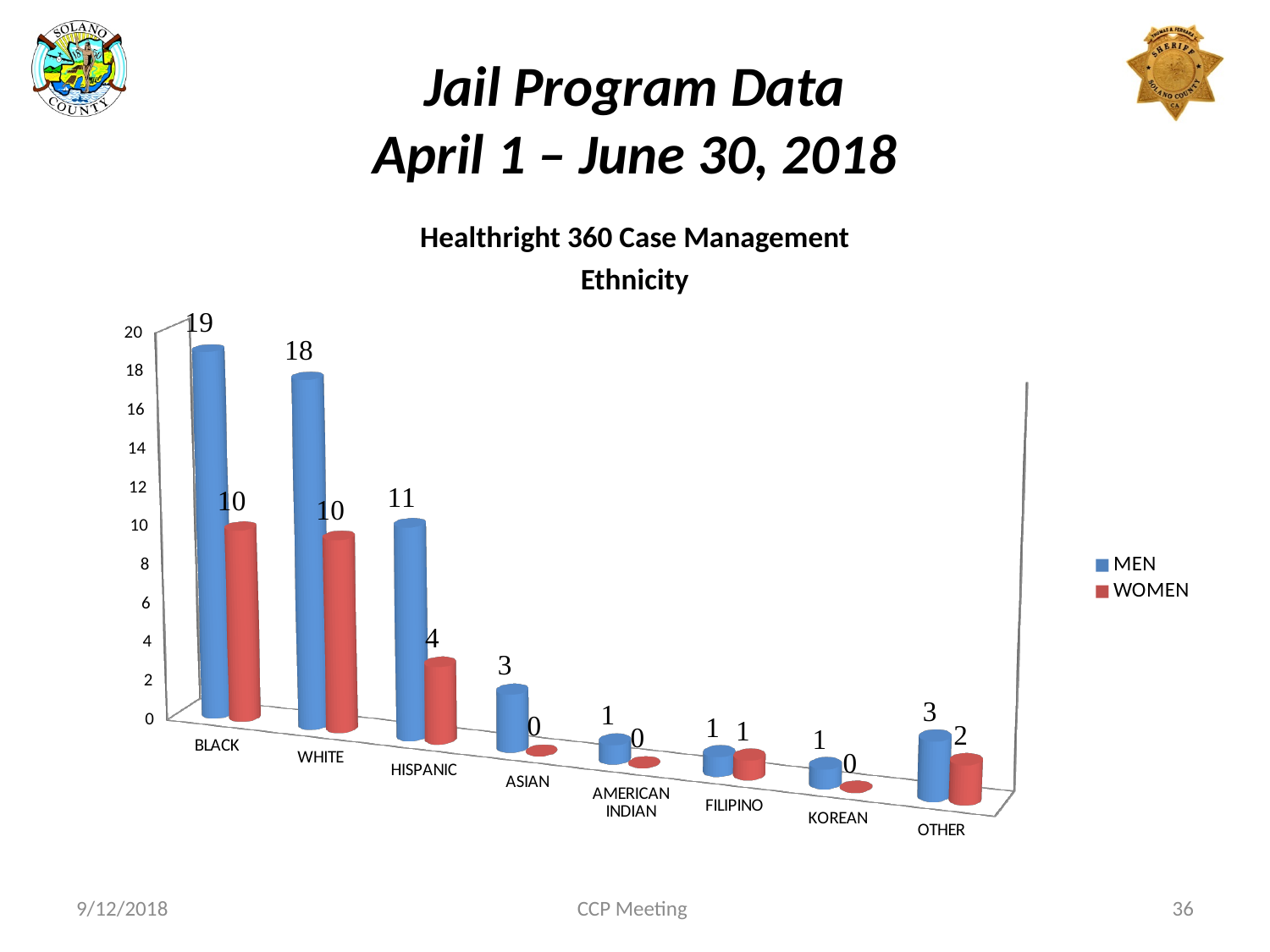
What is the difference between the MEN and WOMEN values in the WHITE category? 8 Which is larger, the MEN value for HISPANIC or the MEN value for ASIAN? HISPANIC What kind of chart is shown on the slide? Bar chart What is the total of MEN and WOMEN in the FILIPINO category? 2 How many ethnicity categories are shown on the x axis? 8 What is the value for MEN in the OTHER category? 3 What is the value for MEN in the BLACK category? 19 How many series does the legend list? 2 Which ethnicity category has the highest value for MEN? BLACK What is the value for WOMEN in the HISPANIC category? 4 What colour represents the WOMEN series in the chart? Red Which ethnicity category has the highest value for WOMEN? BLACK and WHITE (both 10)